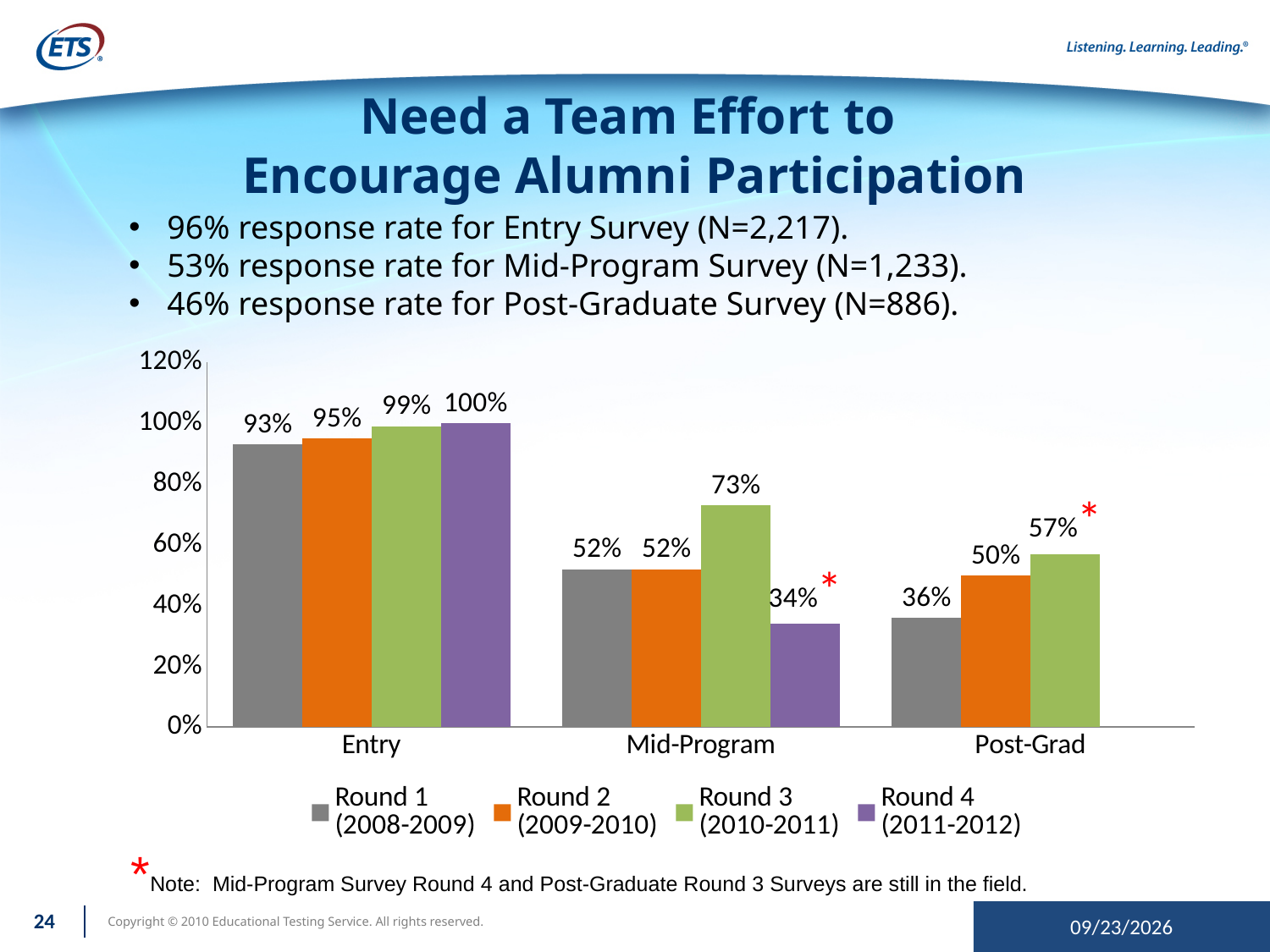
What is the difference between the Round 3 (2010-2011) and Round 1 (2008-2009) values in the Post-Grad category? 21% What is the value for Round 3 (2010-2011) in the Mid-Program category? 73% How many categories are shown on the x axis? 3 Which category has no Round 4 (2011-2012) bar? Post-Grad What kind of chart is shown on the slide? bar chart What is the value for Round 1 (2008-2009) in the Post-Grad category? 36% Which is larger: the Round 2 (2009-2010) value for Mid-Program or the Round 2 (2009-2010) value for Post-Grad? Mid-Program Which round has the highest value in the Entry category? Round 4 (2011-2012) Is the value for Round 4 (2011-2012) in the Mid-Program category greater or less than 40%? less What is the value for Round 4 (2011-2012) in the Entry category? 100% Which round has the lowest value in the Mid-Program category? Round 4 (2011-2012) How many series does the legend list? 4